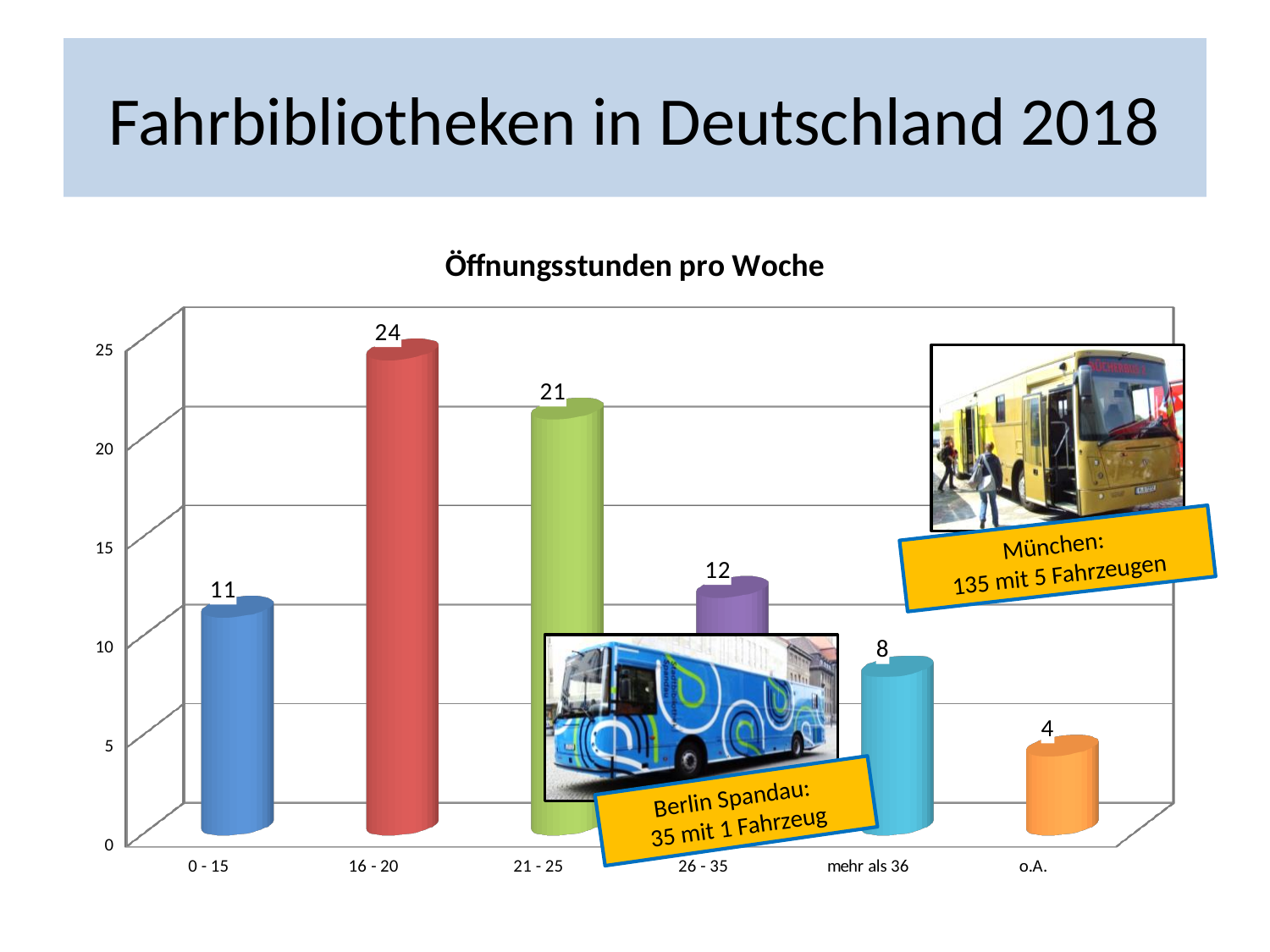
Which category has the highest value? 16 - 20 What is the value for the '16 - 20' category? 24 How many categories are shown on the x axis? 6 What is the value for the '0 - 15' category? 11 What is the value for the 'mehr als 36' category? 8 What is the title of the chart? Öffnungsstunden pro Woche What is the value for the 'o.A.' category? 4 Is the value for '21 - 25' greater or less than 20? greater Which category has the lowest value? o.A. What is the difference between the values for '16 - 20' and '21 - 25'? 3 What kind of chart is shown on the slide? bar chart Which is larger, the value for '26 - 35' or the value for 'mehr als 36'? 26 - 35